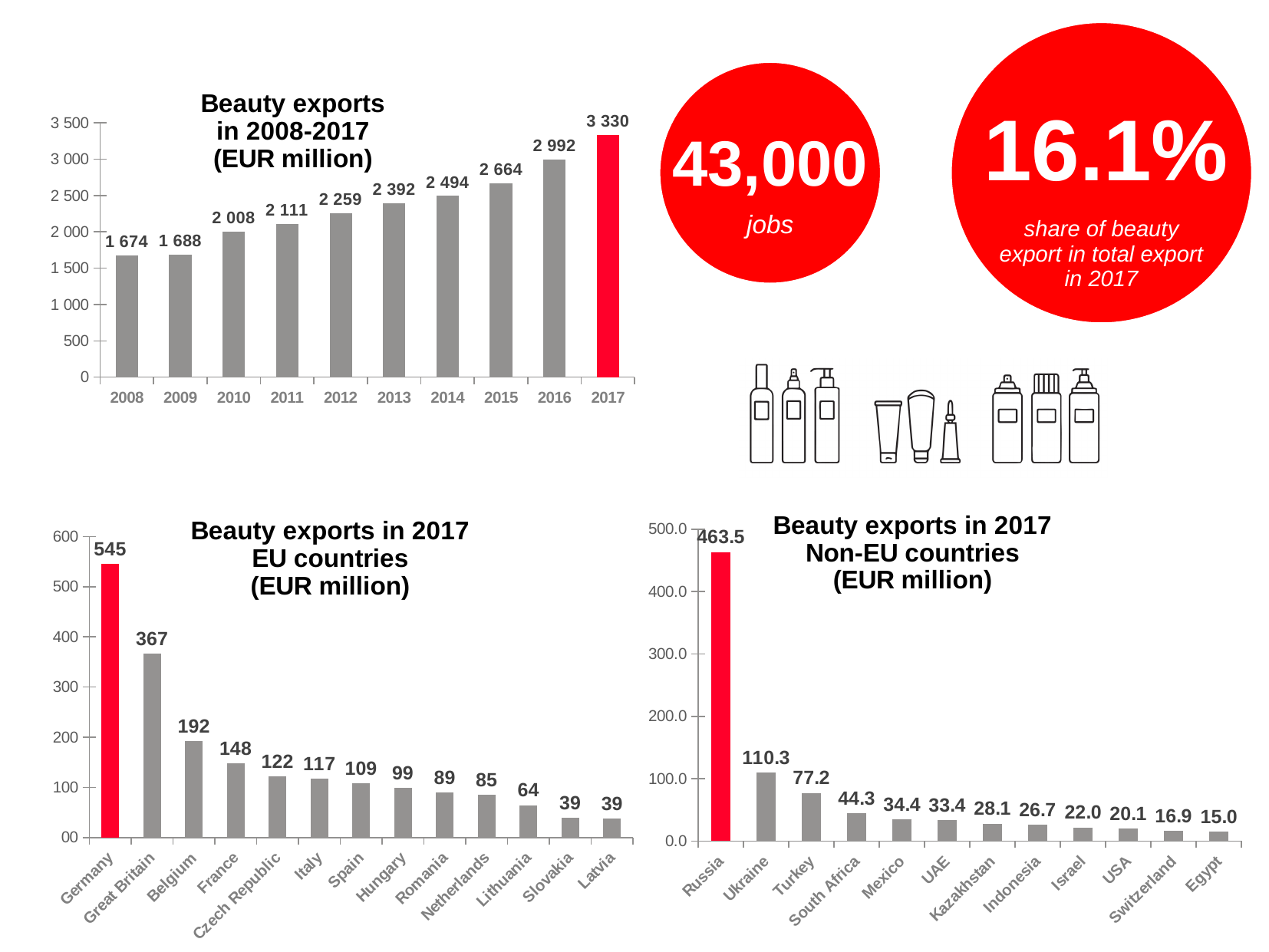
In the 'Beauty exports in 2017 EU countries (EUR million)' chart, what is the difference between Germany and Great Britain? 178 In the 'Beauty exports in 2008-2017 (EUR million)' chart, do the values rise or fall from 2008 to 2017? rise In the 'Beauty exports in 2008-2017 (EUR million)' chart, what is the value for 2012? 2 259 In the 'Beauty exports in 2017 EU countries (EUR million)' chart, which country has the highest value? Germany In the 'Beauty exports in 2017 Non-EU countries (EUR million)' chart, which country has the lowest value? Egypt What kind of chart is the 'Beauty exports in 2017 Non-EU countries (EUR million)' chart? bar chart In the 'Beauty exports in 2008-2017 (EUR million)' chart, what is the value for 2017? 3 330 In the 'Beauty exports in 2017 EU countries (EUR million)' chart, which is larger, Italy or Spain? Italy In the 'Beauty exports in 2008-2017 (EUR million)' chart, how many years are shown? 10 In the 'Beauty exports in 2017 Non-EU countries (EUR million)' chart, what is the value for Ukraine? 110.3 In the 'Beauty exports in 2017 EU countries (EUR million)' chart, what is the value for Belgium? 192 In the 'Beauty exports in 2008-2017 (EUR million)' chart, what is the difference between the 2017 and 2016 values? 338